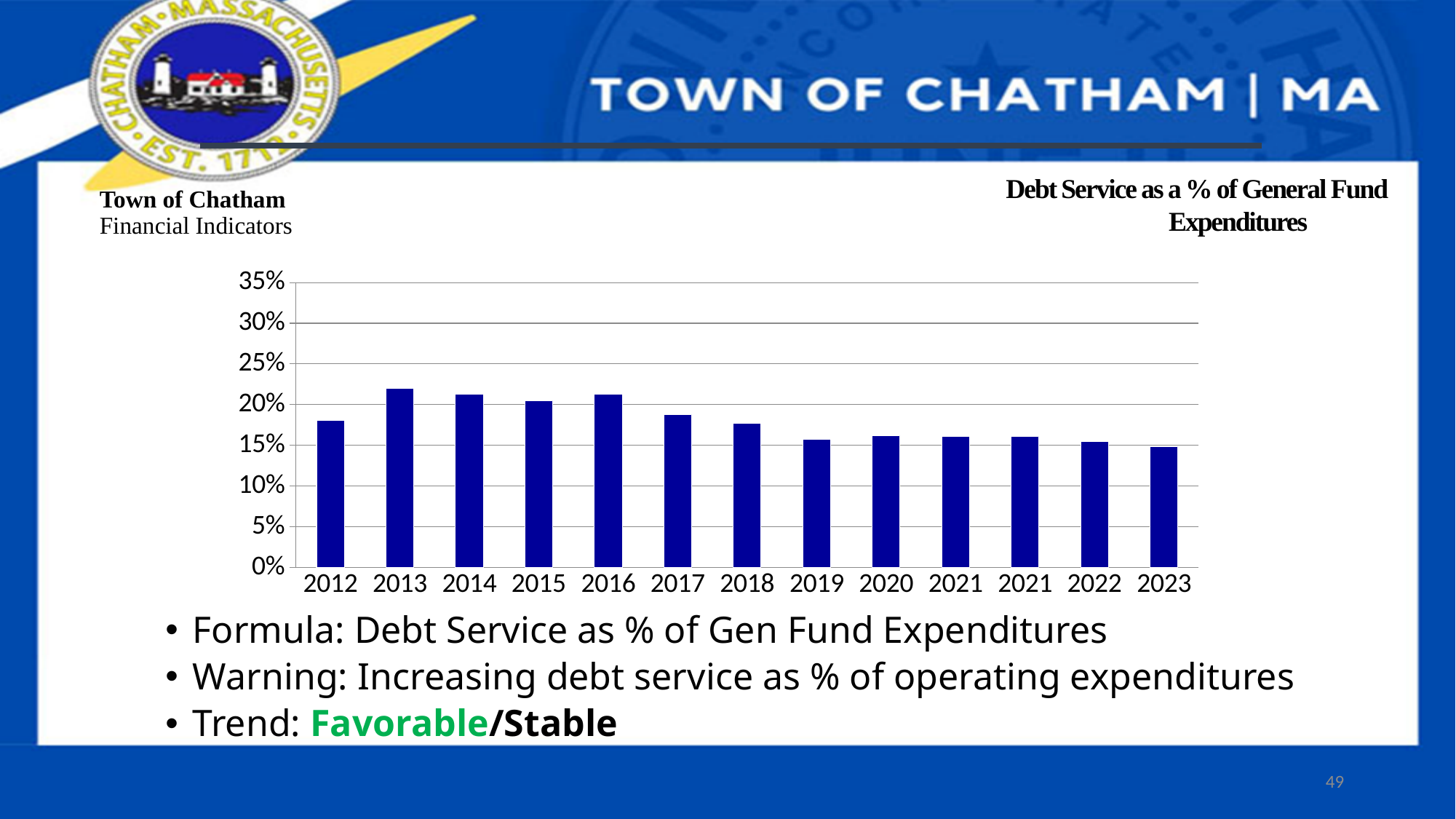
Which year has the larger value, 2013 or 2023? 2013 Do the values generally rise or fall from 2013 to 2023? fall Which year has the larger value, 2019 or 2016? 2016 Is the value for 2012 greater or less than 20%? less What is the title of the chart? Debt Service as a % of General Fund Expenditures How many bars are plotted in the chart? 13 Is the value for 2013 greater or less than 20%? greater Which year has the lowest debt service as a % of general fund expenditures? 2023 Which year has the highest debt service as a % of general fund expenditures? 2013 Is the value for 2017 greater or less than 15%? greater What kind of chart is shown on the slide? bar chart